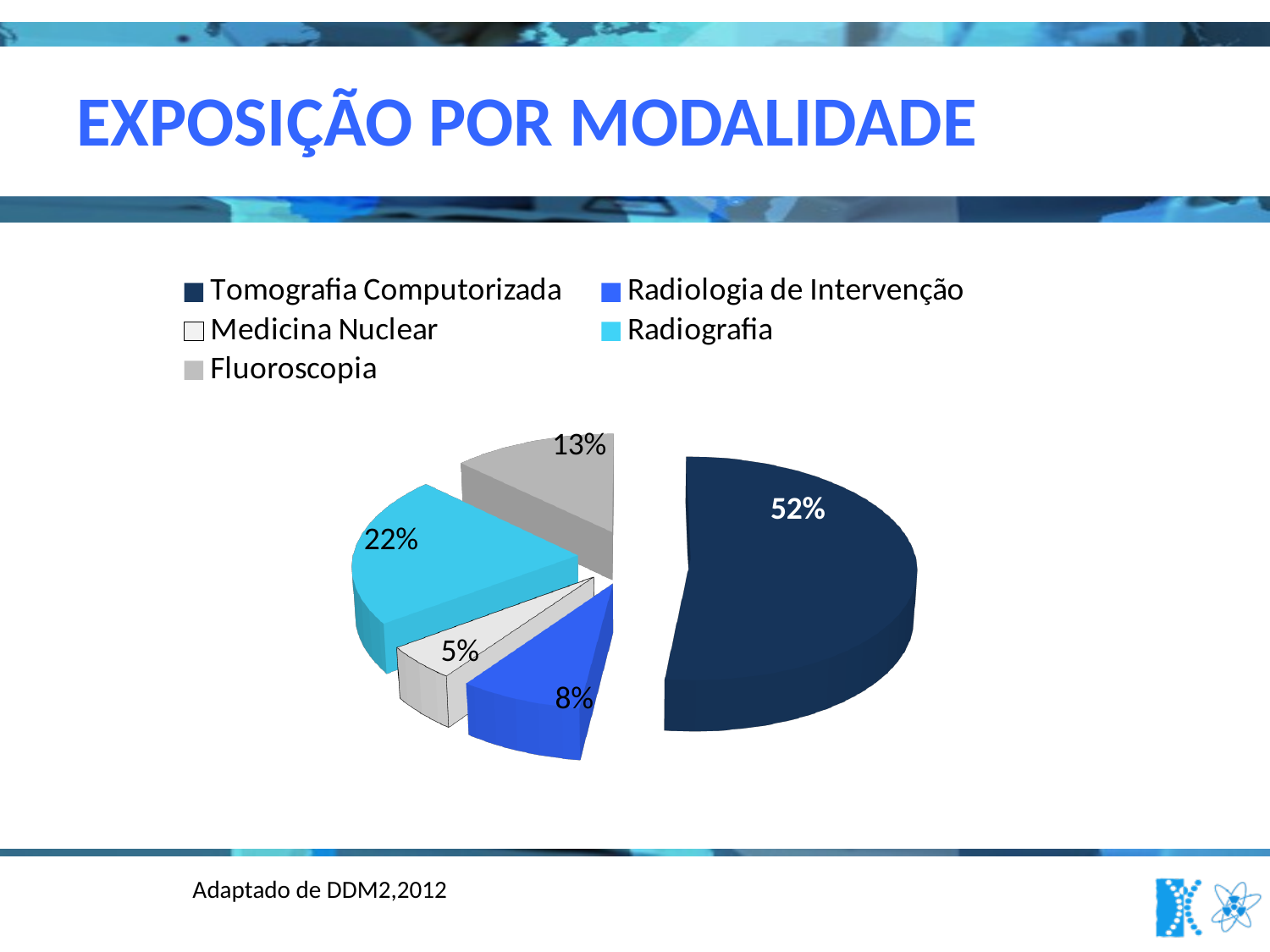
What share of the pie does Fluoroscopia have? 13% What share of the pie does Tomografia Computorizada have? 52% How many slices does the pie chart have? 5 What is the title of the slide containing the pie chart? EXPOSIÇÃO POR MODALIDADE Which modality has the smallest slice of the pie? Medicina Nuclear What share of the pie does Medicina Nuclear have? 5% What type of chart is shown on the slide? Pie chart What share of the pie does Radiologia de Intervenção have? 8% What share of the pie does Radiografia have? 22% Which is larger, the share for Fluoroscopia or the share for Radiologia de Intervenção? Fluoroscopia Which modality has the largest slice of the pie? Tomografia Computorizada What is the difference between the shares of Tomografia Computorizada and Radiografia? 30%